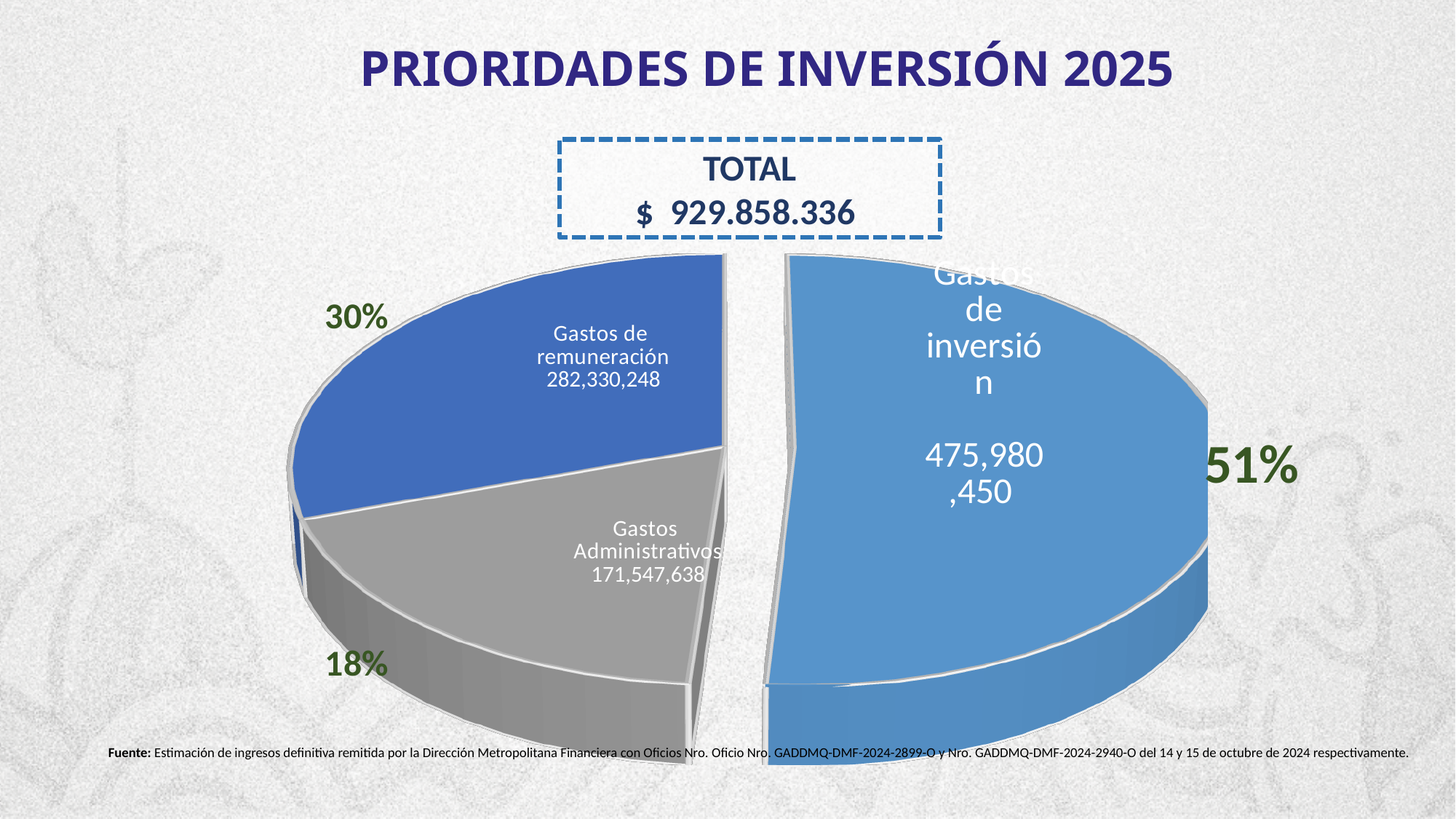
What is the value for Gastos Administrativos? 171,547,638 What share of the pie does Gastos Administrativos represent? 18% Which category has the smallest slice of the pie? Gastos Administrativos What share of the pie does Gastos de inversión represent? 51% What is the value for Gastos de remuneración? 282,330,248 Which category has the largest slice of the pie? Gastos de inversión What is the value for Gastos de inversión? 475,980,450 What share of the pie does Gastos de remuneración represent? 30% What is the difference between the values for Gastos de inversión and Gastos de remuneración? 193,650,202 What total amount is shown in the box above the pie chart? $ 929.858.336 How many categories are shown in the pie chart? 3 What kind of chart is shown on the slide? pie chart